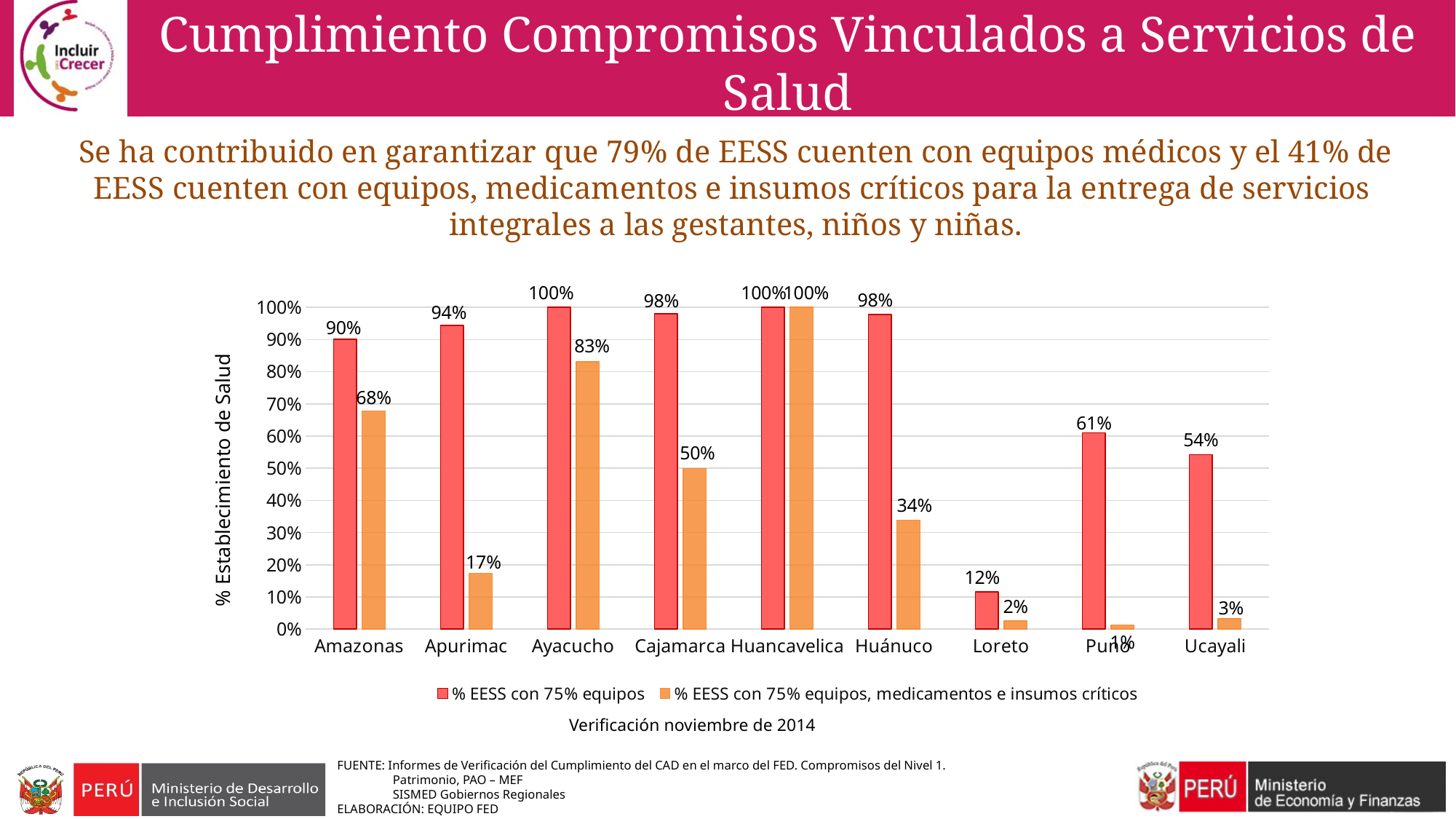
Which region has the lowest value for "% EESS con 75% equipos, medicamentos e insumos críticos"? Puno What is the difference between the two series for Amazonas? 22 percentage points Which is larger: "% EESS con 75% equipos" for Puno or for Ucayali? Puno What kind of chart is shown on the slide? Bar chart What is the value of "% EESS con 75% equipos, medicamentos e insumos críticos" for Apurimac? 17% Which region has the highest value for "% EESS con 75% equipos, medicamentos e insumos críticos"? Huancavelica What is the value of "% EESS con 75% equipos" for Loreto? 12% What is the value of "% EESS con 75% equipos" for Amazonas? 90% How many series does the legend list? 2 What is the title of the vertical axis? % Establecimiento de Salud How many regions are shown on the x axis? 9 Which region has the lowest value for "% EESS con 75% equipos"? Loreto